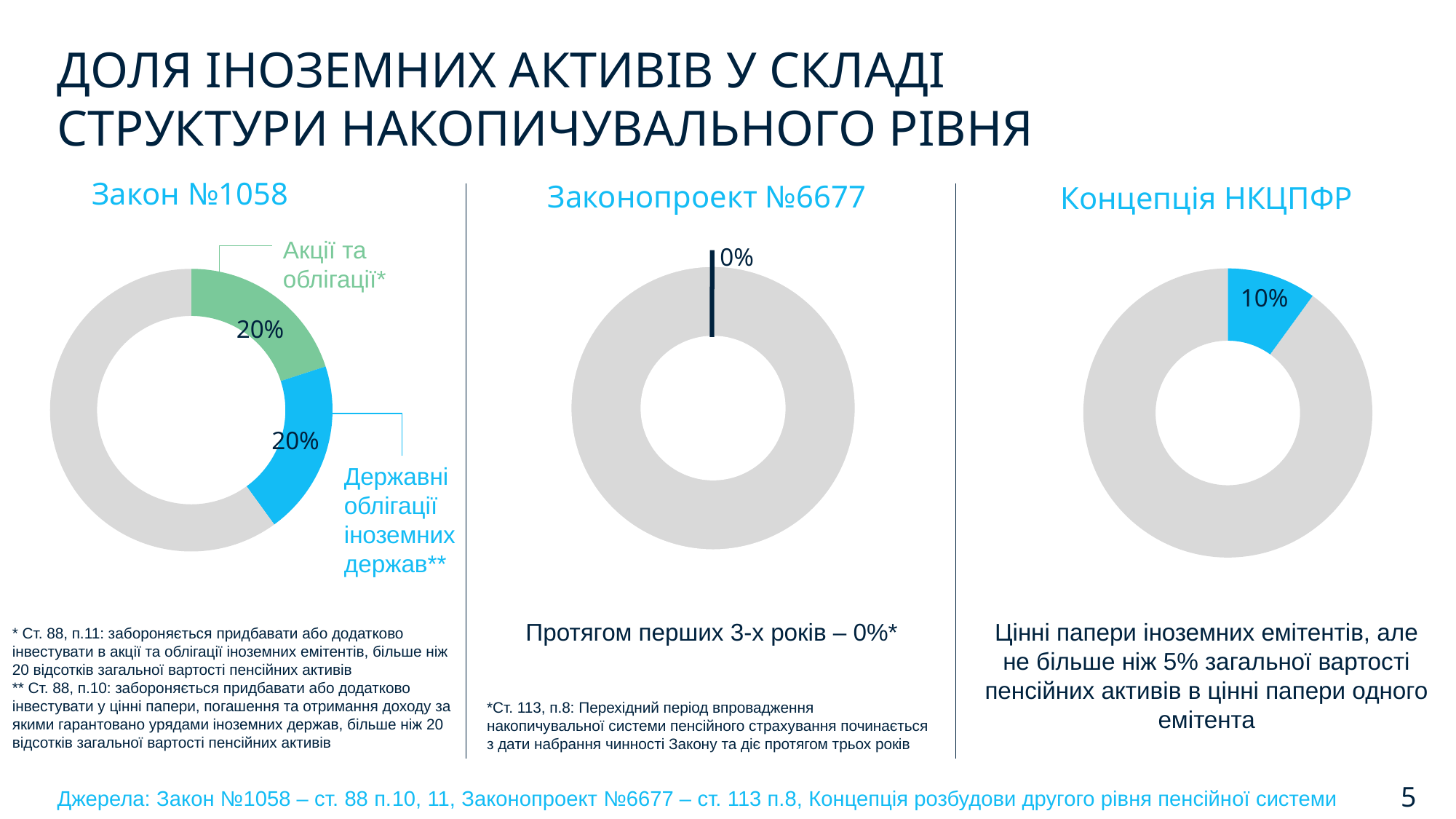
In the chart titled "Закон №1058", what is the value shown for "Державні облігації іноземних держав**"? 20% In the chart titled "Закон №1058", what colour is the "Державні облігації іноземних держав**" slice? Blue What is the difference between the "Державні облігації іноземних держав**" share in the "Закон №1058" chart and the labelled share in the "Концепція НКЦПФР" chart? 10% In the chart titled "Закон №1058", what colour is the "Акції та облігації*" slice? Green Which chart shows the larger labelled share: "Концепція НКЦПФР" (10%) or "Законопроект №6677" (0%)? Концепція НКЦПФР How many donut charts are shown on the slide? 3 In the chart titled "Закон №1058", what is the value shown for "Акції та облігації*"? 20% In the chart titled "Законопроект №6677", what value is labelled on the chart? 0% In the chart titled "Закон №1058", what is the combined share of the two labelled slices ("Акції та облігації*" and "Державні облігації іноземних держав**")? 40% In the chart titled "Закон №1058", how many slices have a printed percentage label? 2 In the chart titled "Концепція НКЦПФР", what value is labelled on the highlighted slice? 10% What kind of chart is used under the heading "Закон №1058"? Donut (pie) chart